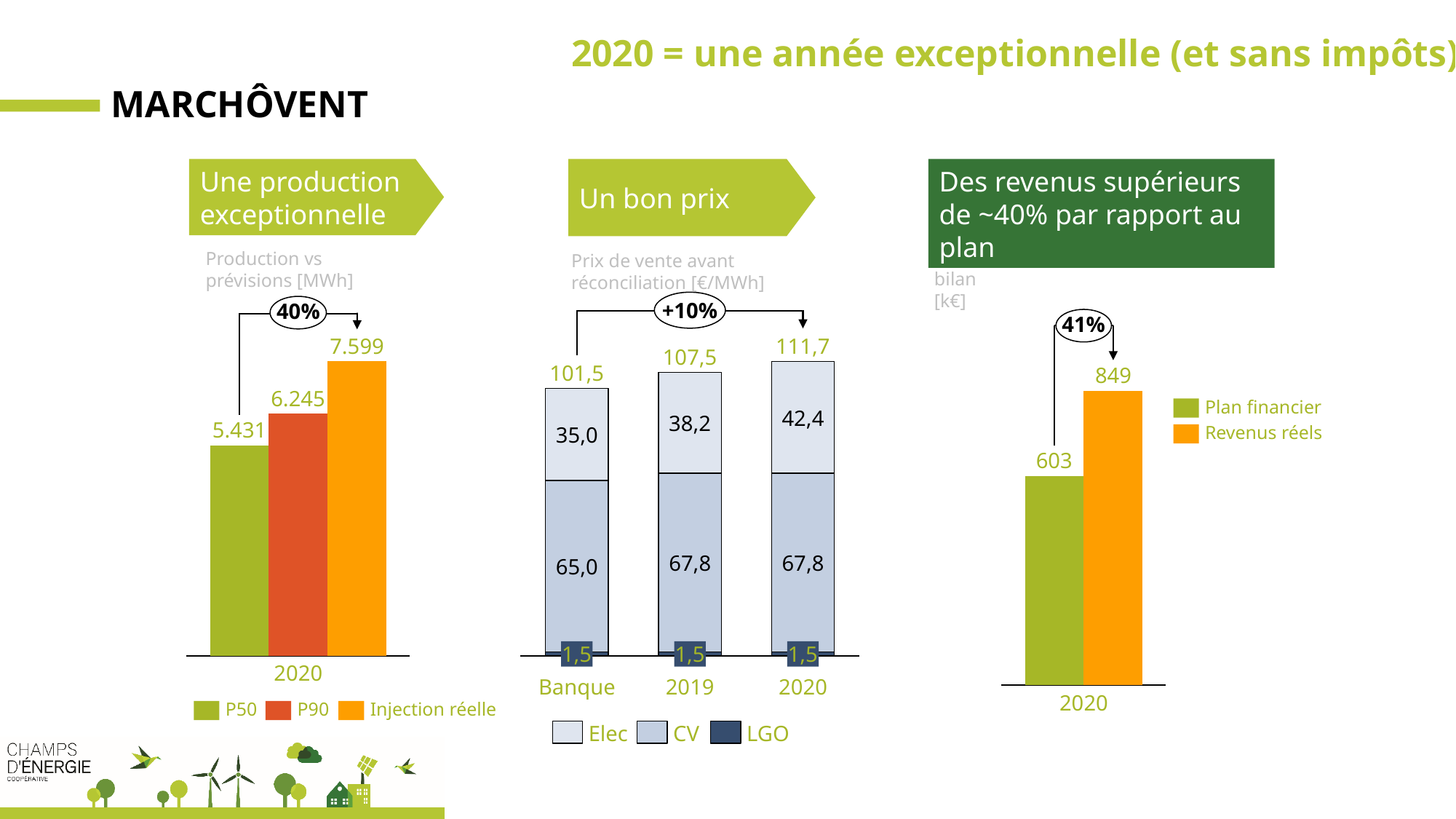
In the middle chart (Prix de vente avant réconciliation [€/MWh]), what is the total of the Banque bar? 101,5 In the right chart (bilan [k€]), what is the value for Revenus réels? 849 In the middle chart (Prix de vente avant réconciliation [€/MWh]), do the bar totals rise or fall from Banque to 2020? rise In the left chart (Production vs prévisions [MWh]), how many series does the legend list? 3 In the middle chart (Prix de vente avant réconciliation [€/MWh]), how many bars are shown? 3 In the left chart (Production vs prévisions [MWh]), which series has the lowest value? P50 What kind of chart is the right chart (bilan [k€])? bar chart In the left chart (Production vs prévisions [MWh]), what is the difference between Injection réelle and P50? 2.168 In the right chart (bilan [k€]), what is the difference between Revenus réels and Plan financier? 246 In the middle chart (Prix de vente avant réconciliation [€/MWh]), what is the CV value for 2019? 67,8 In the left chart (Production vs prévisions [MWh]), what is the value for Injection réelle in 2020? 7.599 In the middle chart (Prix de vente avant réconciliation [€/MWh]), what is the Elec value for 2020? 42,4